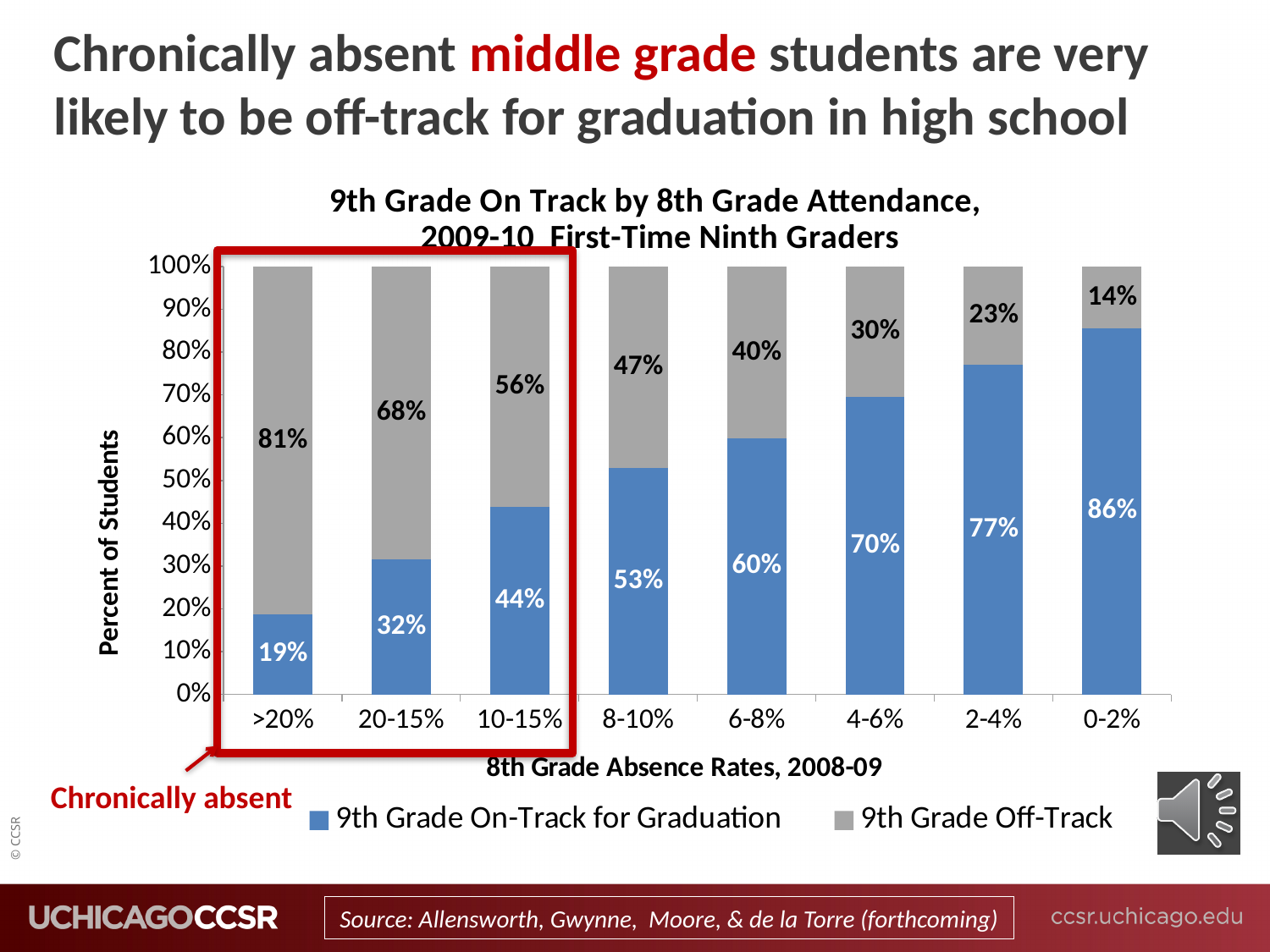
How many absence rate categories are shown on the x axis? 8 How many series does the legend list? 2 What percentage of students with an 8th grade absence rate of >20% were 9th Grade On-Track for Graduation? 19% What kind of chart is shown on the slide? Stacked bar chart Does the 9th Grade On-Track for Graduation value rise or fall moving from >20% to 0-2% along the x axis? Rise Which is larger: the 9th Grade Off-Track value for 20-15% or for 8-10%? 20-15% Which absence rate category has the highest 9th Grade On-Track for Graduation value? 0-2% What is the 9th Grade Off-Track value for the 0-2% absence rate category? 14% What is the difference between the 9th Grade On-Track values for the 0-2% and >20% absence rate categories? 67% Which absence rate category has the lowest 9th Grade On-Track for Graduation value? >20% What is the title of the chart? 9th Grade On Track by 8th Grade Attendance, 2009-10 First-Time Ninth Graders What is the 9th Grade On-Track for Graduation value for the 6-8% absence rate category? 60%